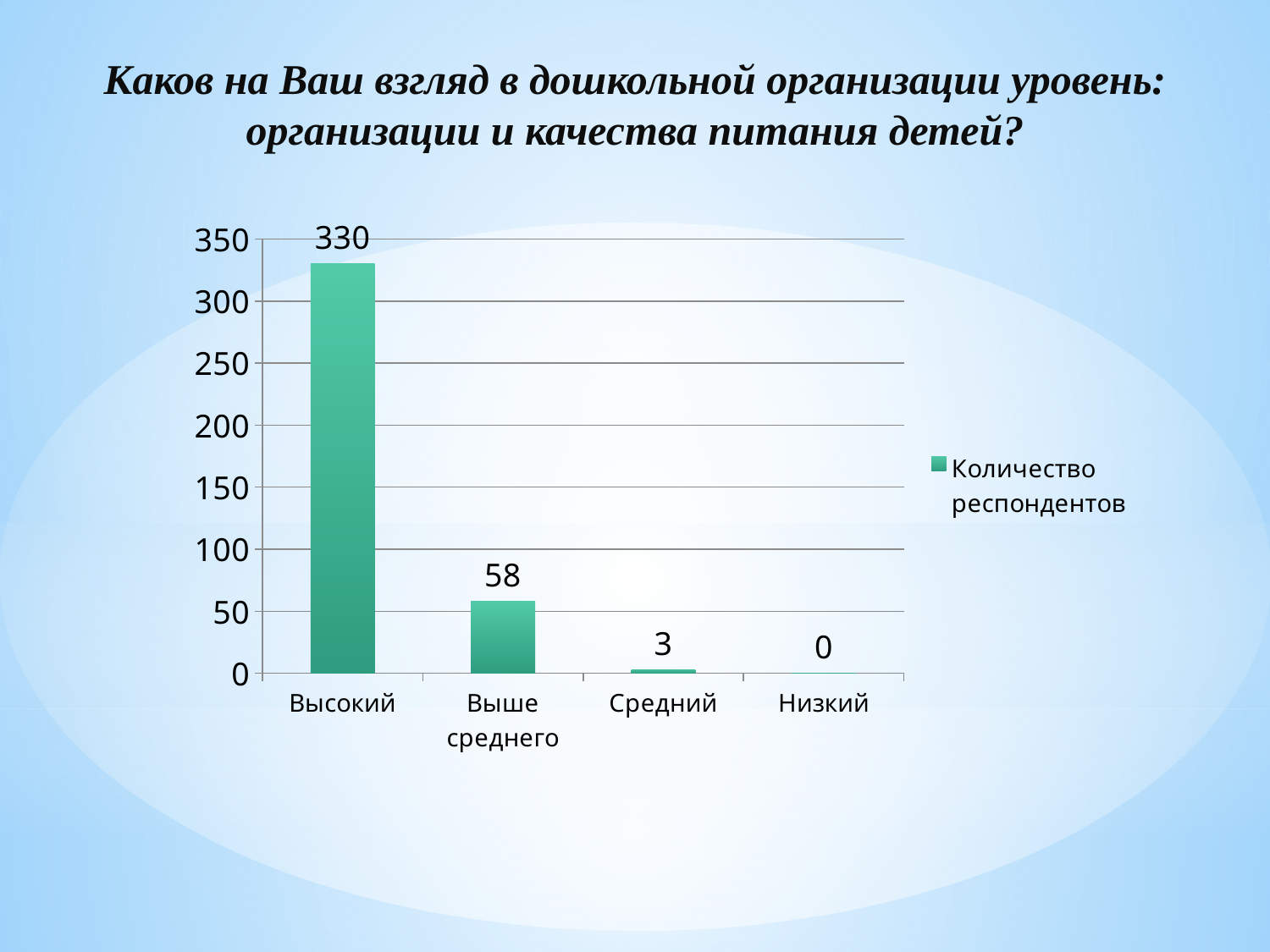
Which is larger, the value for Выше среднего or the value for Средний? Выше среднего What is the difference between the values for Высокий and Выше среднего? 272 What is the value for Выше среднего? 58 How many series does the legend list? 1 What is the value for Низкий? 0 Which category has the highest value? Высокий Is the value for Высокий greater or less than 300? greater Which category has the lowest value? Низкий What is the value for Средний? 3 What kind of chart is shown on the slide? bar chart What is the value for Высокий? 330 How many categories are shown on the x axis? 4